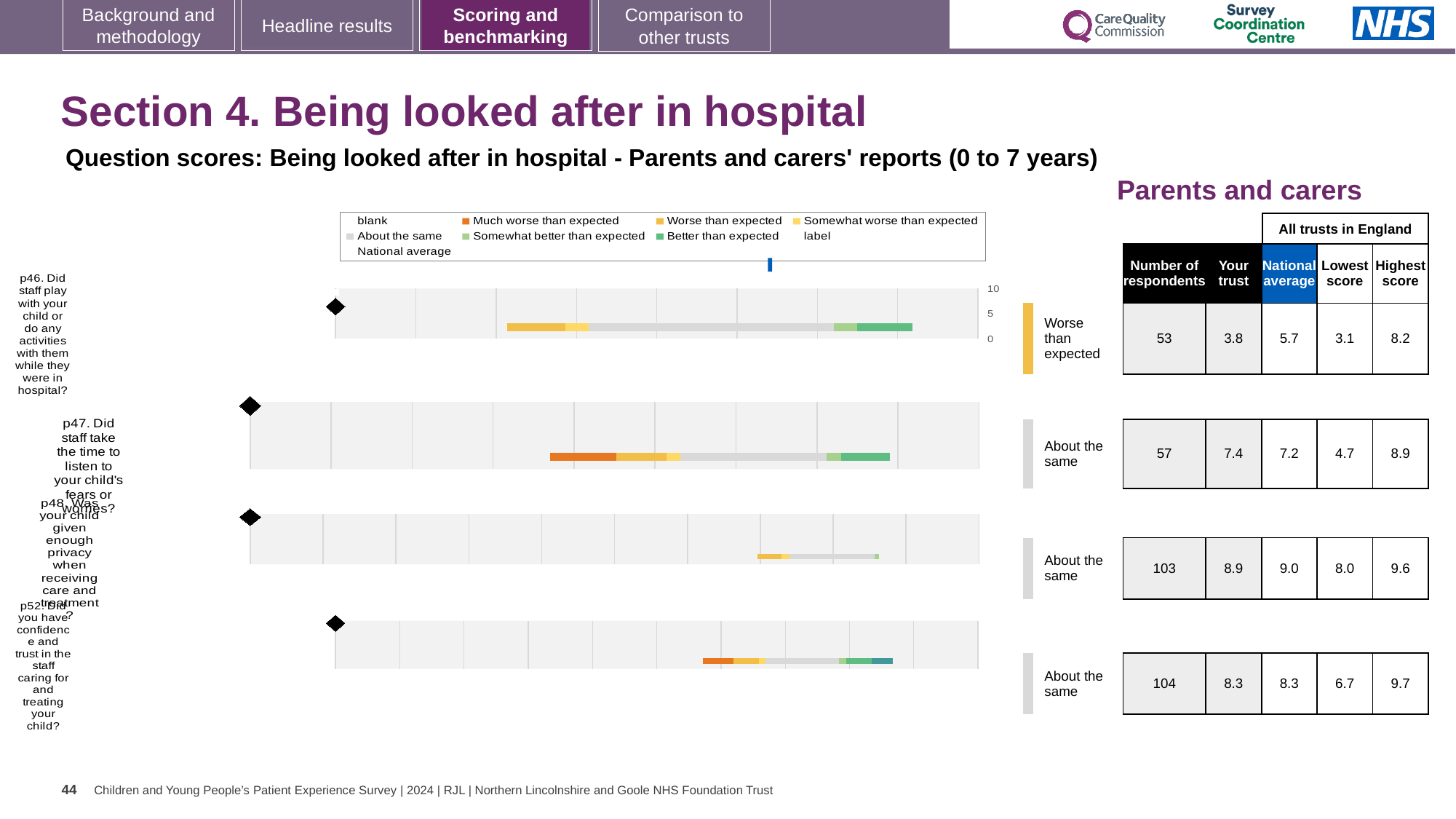
Which question has the lowest 'Your trust' score? p46 What is the highest score across all trusts in England for p52 (Did you have confidence and trust in the staff caring for and treating your child?)? 9.7 What is the 'Your trust' score for p46 (Did staff play with your child or do any activities with them while they were in hospital?)? 3.8 What type of chart is used to show the question scores on this slide? bar chart Which question has the highest 'Your trust' score? p48 Is the 'Your trust' score for p47 higher or lower than the national average? higher What is the difference between the national average and the 'Your trust' score for p46? 1.9 How many respondents answered p48 (Was your child given enough privacy when receiving care and treatment?)? 103 How many question charts (p46, p47, p48, p52) are shown on the slide? 4 Which question is rated 'Worse than expected' for this trust? p46 What is the national average for p47 (Did staff take the time to listen to your child's fears or worries?)? 7.2 What is the lowest score across all trusts in England for p47? 4.7